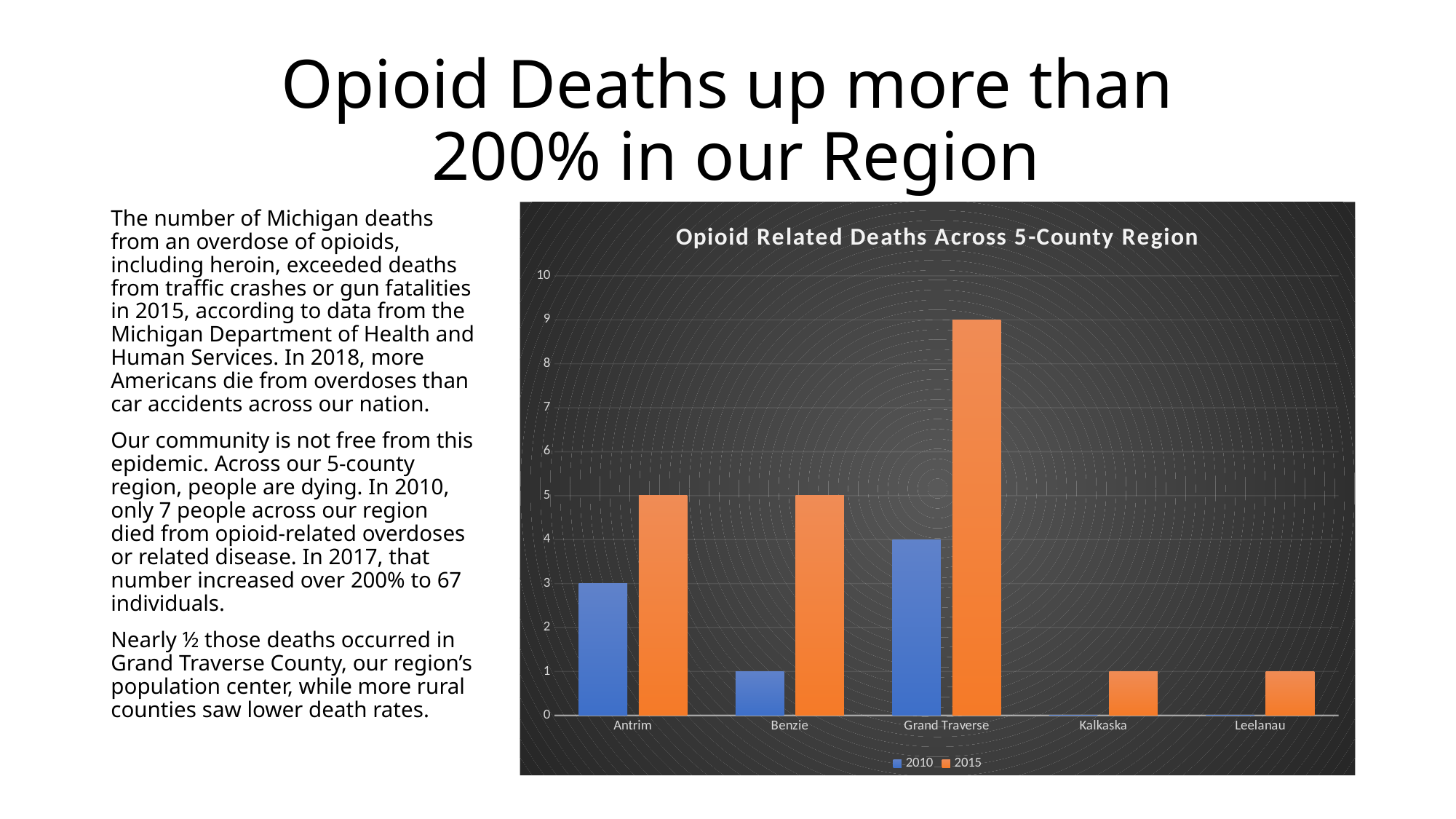
Which colour represents the 2015 series in the chart? orange What type of chart is shown on the slide? bar chart What is the 2015 value for Benzie? 5 Is the 2015 value for Antrim greater or less than the 2010 value for Antrim? greater What is the 2010 value for Antrim? 3 Which county has the lowest 2010 value, Benzie or Grand Traverse? Benzie How many series does the chart legend list? 2 What is the 2015 value for Grand Traverse? 9 What is the title of the chart? Opioid Related Deaths Across 5-County Region What is the difference between the 2015 and 2010 values for Grand Traverse? 5 Which county has the highest 2015 value? Grand Traverse How many counties are shown on the x axis of the chart? 5